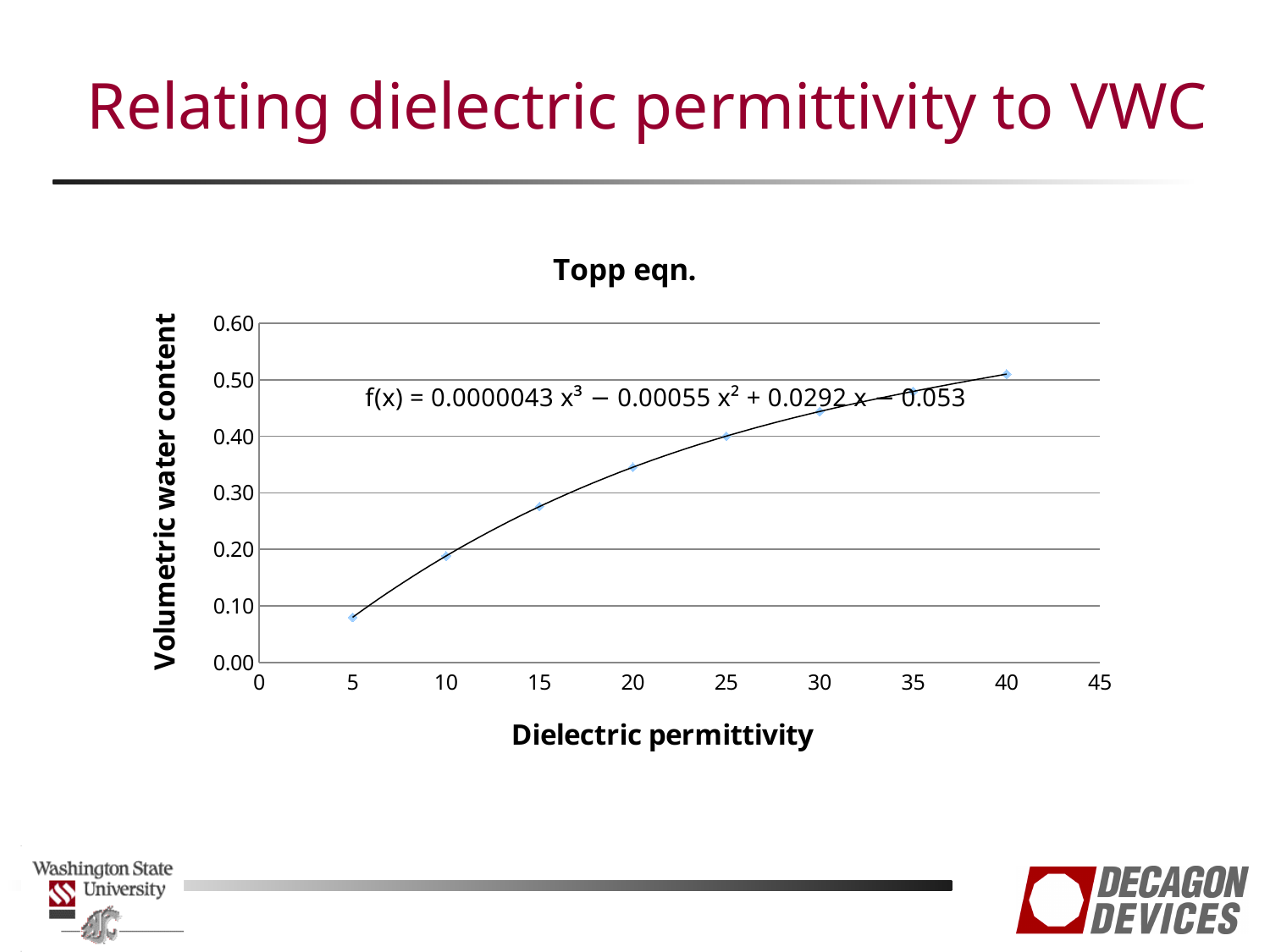
What is the label of the x axis? Dielectric permittivity At which dielectric permittivity value is the volumetric water content lowest? 5 Does volumetric water content rise or fall as dielectric permittivity increases? rise What kind of chart is shown on the slide? scatter chart with a fitted curve What is the title of the chart? Topp eqn. How many data points are plotted on the chart? 8 Is the volumetric water content at a dielectric permittivity of 5 greater or less than 0.10? less Which has the larger volumetric water content: a dielectric permittivity of 10 or of 25? 25 At which dielectric permittivity value is the volumetric water content highest? 40 Is the volumetric water content at a dielectric permittivity of 20 greater or less than 0.30? greater Is the volumetric water content at a dielectric permittivity of 15 greater or less than 0.30? less